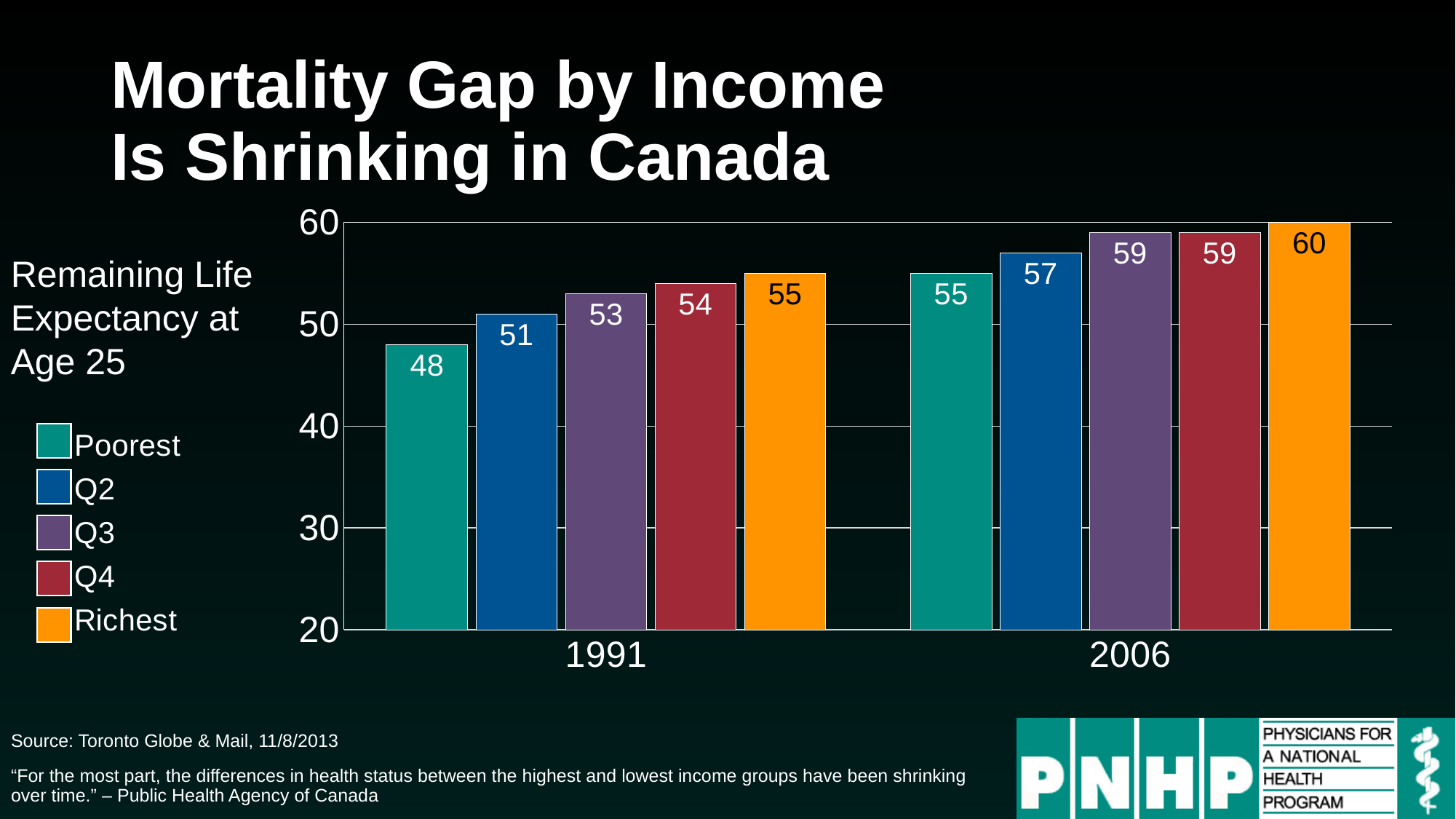
Which income group has the lowest value in 1991? Poorest Does the value for Q4 rise or fall from 1991 to 2006? Rise What is the remaining life expectancy at age 25 for the Richest group in 2006? 60 What is the remaining life expectancy at age 25 for the Poorest group in 1991? 48 What kind of chart is shown on the slide? Bar chart What is the difference between the Richest and Poorest values in 1991? 7 What is the difference between the Richest and Poorest values in 2006? 5 What is the value for Q3 in 1991? 53 What is the value for Q2 in 2006? 57 Which is larger: the Poorest value in 2006 or the Richest value in 1991? They are equal (55) How many series does the legend list? 5 Which income group has the highest value in 2006? Richest